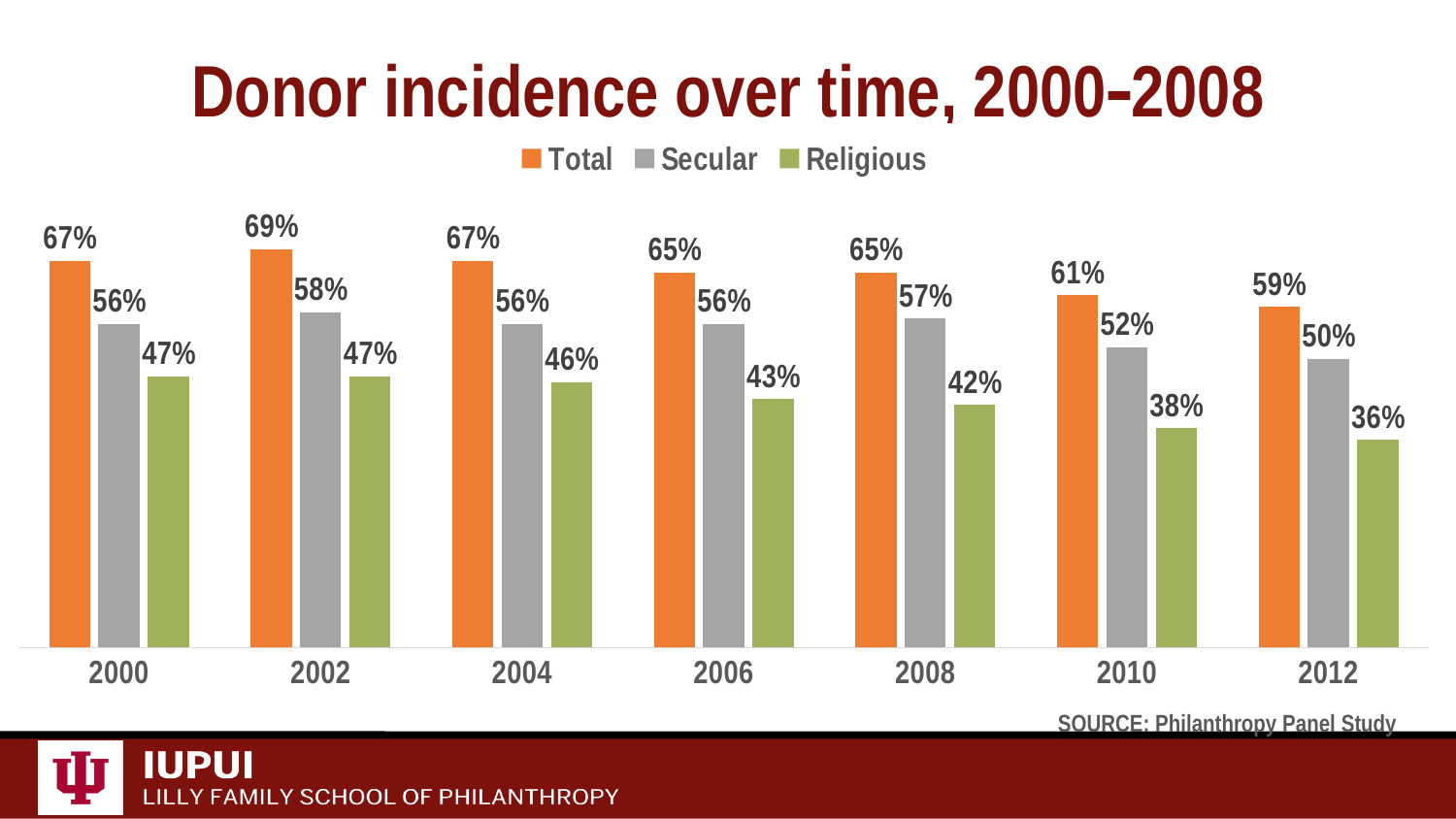
Which is larger in 2006, the Secular or the Religious donor incidence? Secular What is the Religious donor incidence in 2012? 36% What colour represents the Total series in the chart? Orange What kind of chart is shown on the slide? Bar chart What is the difference between the Secular and Religious donor incidence in 2010? 14% In which year is the Religious donor incidence lowest? 2012 What is the Total donor incidence in 2002? 69% How many years are shown on the x axis? 7 What is the Secular donor incidence in 2008? 57% In which year is the Total donor incidence highest? 2002 Does the Religious donor incidence rise or fall from 2004 to 2012? Fall How many series does the legend list? 3